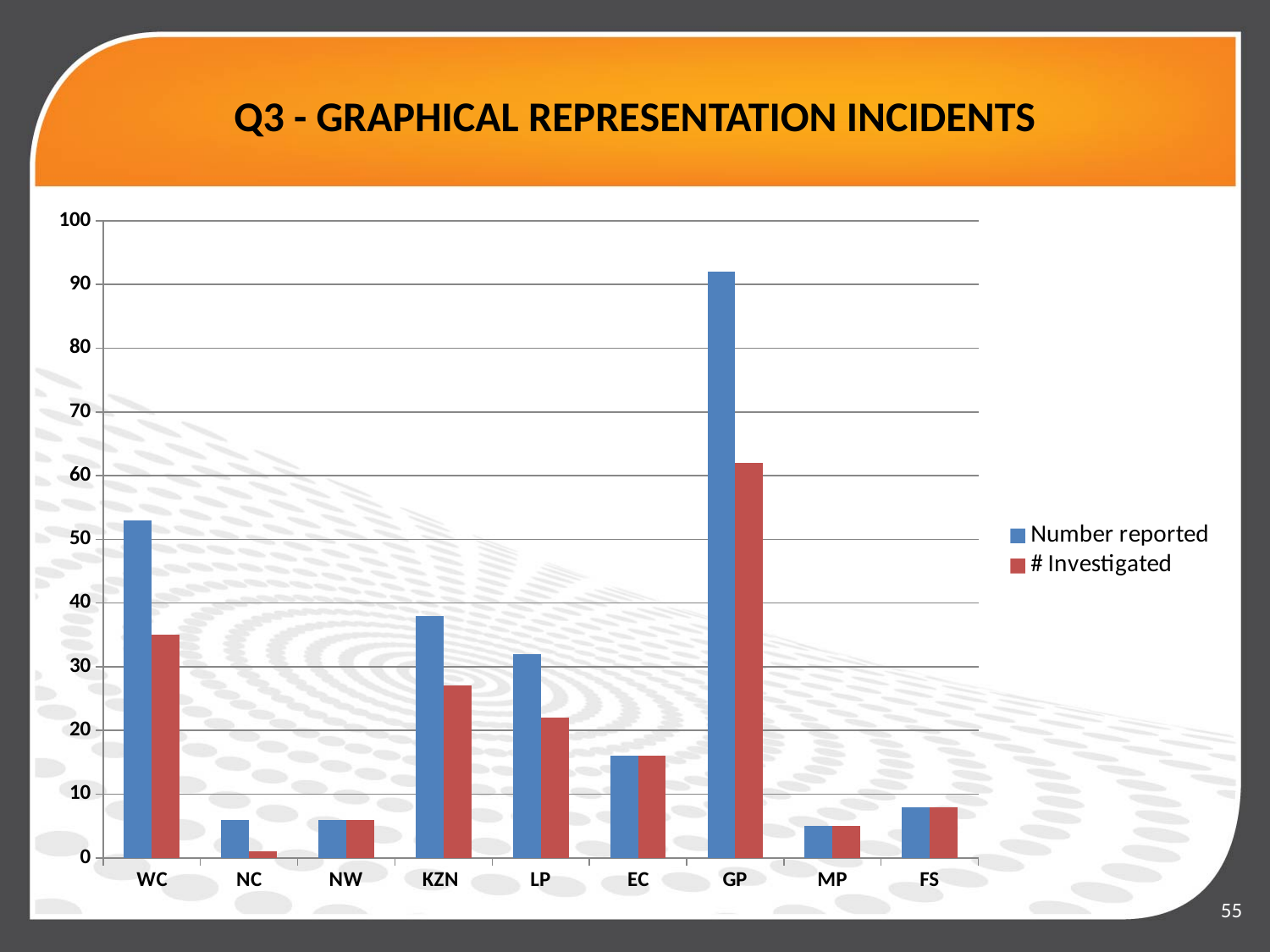
Which is larger: the # Investigated for GP or the Number reported for WC? # Investigated for GP Is the Number reported for GP greater or less than 80? greater How many provinces (categories) are shown on the x axis? 9 What kind of chart is shown on the slide? bar chart How many series does the legend list? 2 Which province has the highest Number reported? GP Is the # Investigated for LP greater or less than 30? less Which province has the lowest # Investigated? NC What is the title of the chart slide? Q3 - GRAPHICAL REPRESENTATION INCIDENTS Which is larger: the Number reported for WC or the Number reported for KZN? WC Which province has the highest # Investigated? GP Is the Number reported for WC greater or less than 50? greater